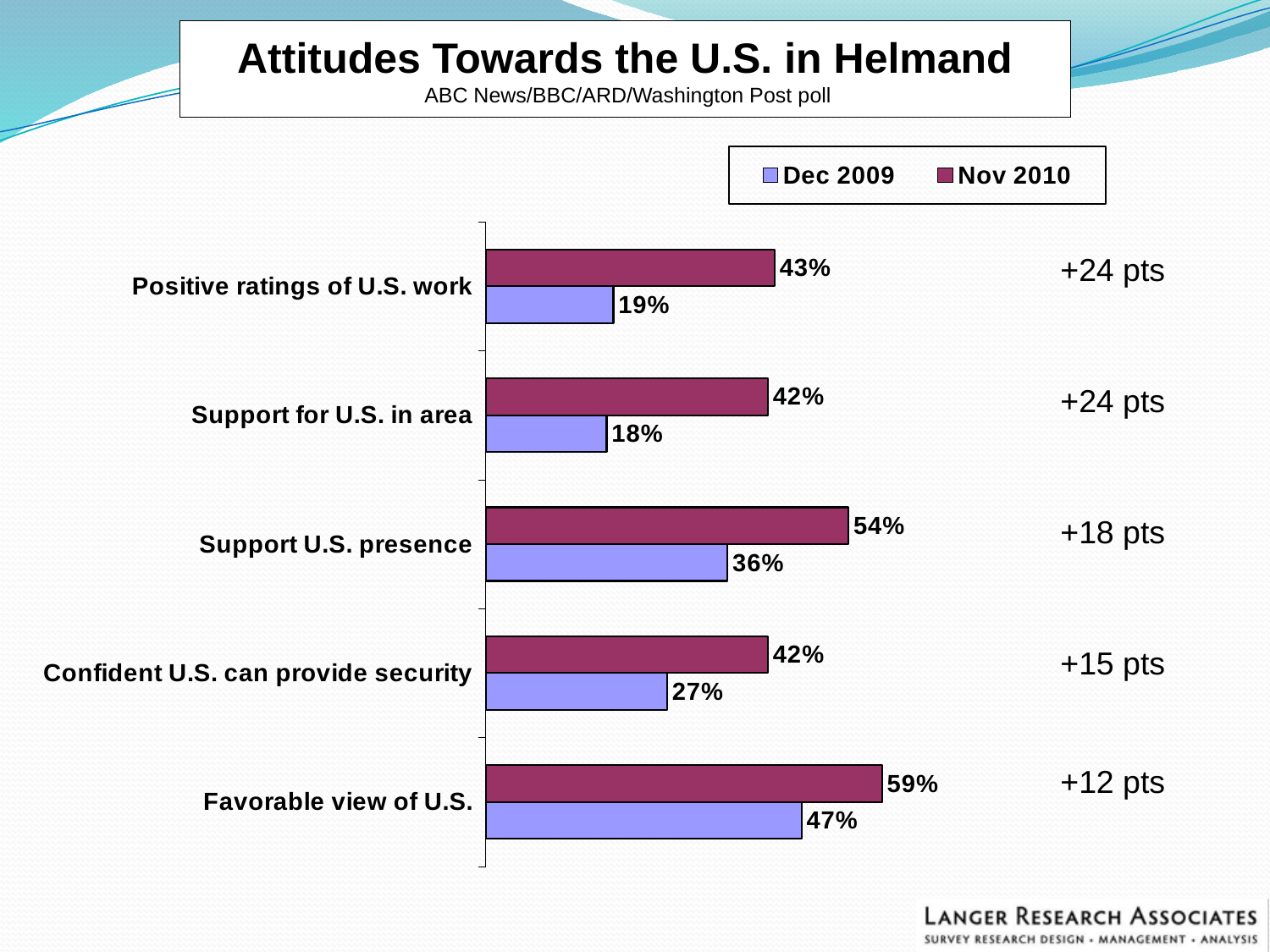
Which category has the highest Nov 2010 value? Favorable view of U.S. How many series does the legend list? 2 What is the Dec 2009 value for "Confident U.S. can provide security"? 27% How many categories are shown in the chart? 5 Which series is shown in the darker (maroon) colour? Nov 2010 What kind of chart is shown on the slide? Bar chart What is the title of the chart? Attitudes Towards the U.S. in Helmand Which is larger: the Dec 2009 value for "Favorable view of U.S." or the Nov 2010 value for "Support for U.S. in area"? Dec 2009 value for Favorable view of U.S. What is the Dec 2009 value for "Support U.S. presence"? 36% What is the difference between the Nov 2010 and Dec 2009 values for "Positive ratings of U.S. work"? 24 pts What is the Nov 2010 value for "Favorable view of U.S."? 59% Which category has the lowest Dec 2009 value? Support for U.S. in area